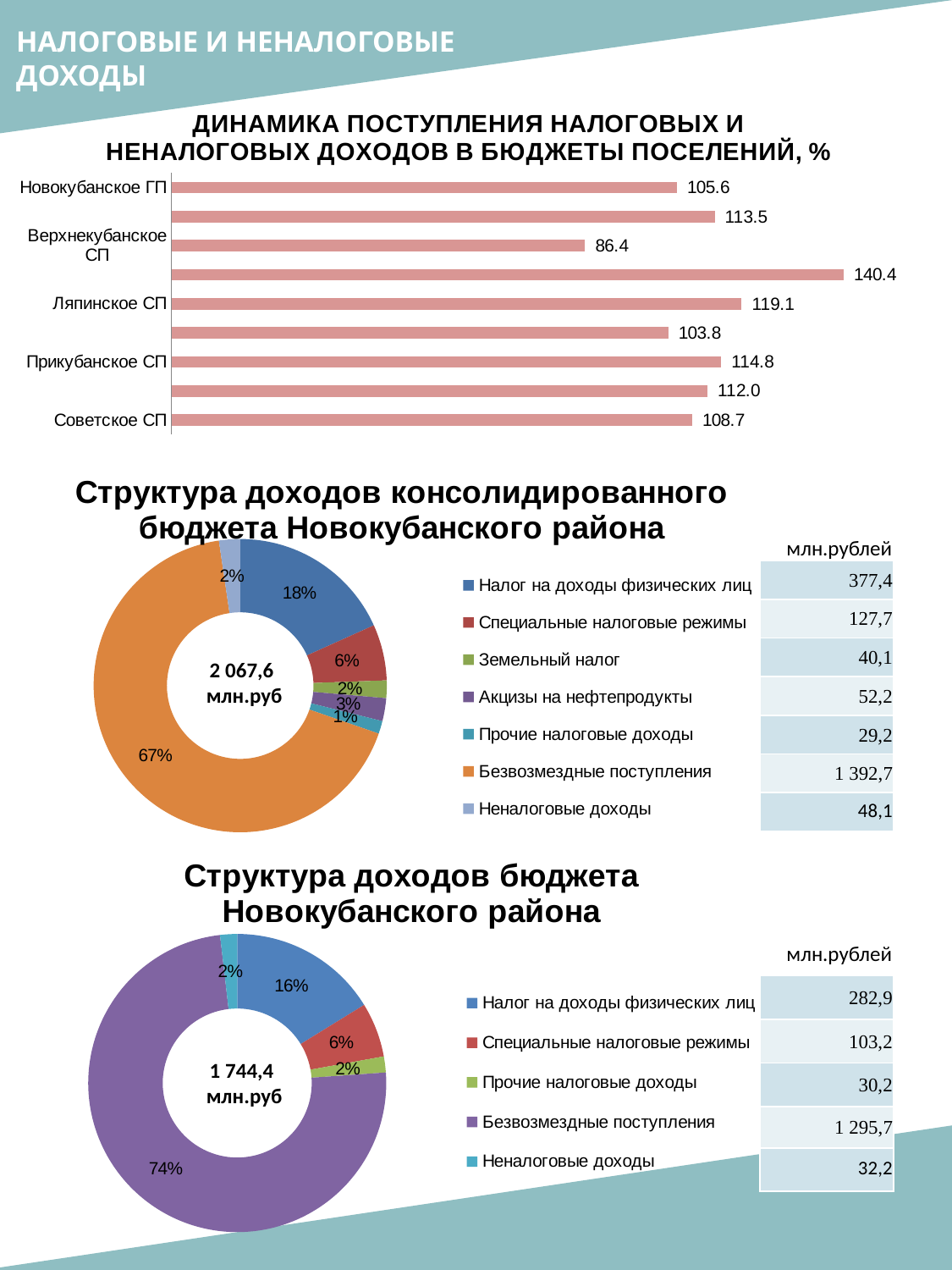
In the top bar chart, what is the value for Ляпинское СП? 119.1 In the top bar chart, what is the difference between the values for Прикубанское СП and Советское СП? 6.1 In the chart 'Структура доходов консолидированного бюджета Новокубанского района', what is the value in млн.рублей for Налог на доходы физических лиц? 377,4 In the top bar chart, which labeled settlement has the lowest value? Верхнекубанское СП In the chart 'Структура доходов бюджета Новокубанского района', what share does Безвозмездные поступления have? 74% What total is shown in the centre of the donut chart 'Структура доходов бюджета Новокубанского района'? 1 744,4 млн.руб What type of chart is the top chart on the slide? Bar chart How many bars are plotted in the top bar chart? 9 In the top bar chart, which is larger: the value for Ляпинское СП or the value for Новокубанское ГП? Ляпинское СП In the top bar chart 'Динамика поступления налоговых и неналоговых доходов в бюджеты поселений, %', what is the value for Новокубанское ГП? 105.6 In the chart 'Структура доходов консолидированного бюджета Новокубанского района', what share does Безвозмездные поступления have? 67% How many categories does the legend list in the chart 'Структура доходов консолидированного бюджета Новокубанского района'? 7